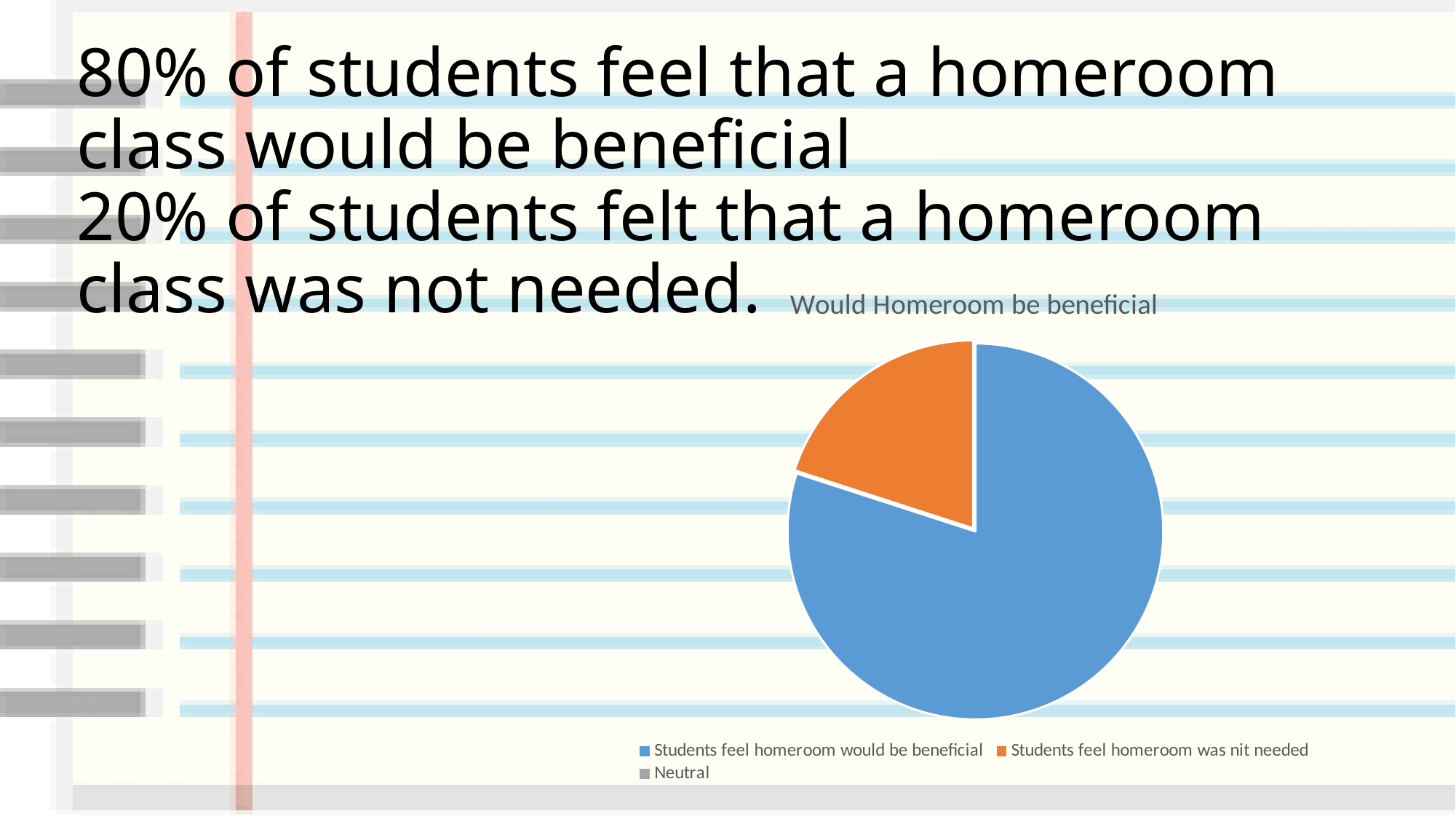
How many slices are visible in the pie chart? 2 What kind of chart is shown on the slide? pie chart Which category has the largest slice of the pie? Students feel homeroom would be beneficial What colour is the slice for 'Students feel homeroom would be beneficial'? blue Which is larger: the slice for 'Students feel homeroom would be beneficial' or the slice for 'Students feel homeroom was nit needed'? Students feel homeroom would be beneficial Which visible slice of the pie is the smallest? Students feel homeroom was nit needed How many entries does the chart legend list? 3 What is the title of the chart? Would Homeroom be beneficial Which legend entry does not have a visible slice in the pie? Neutral